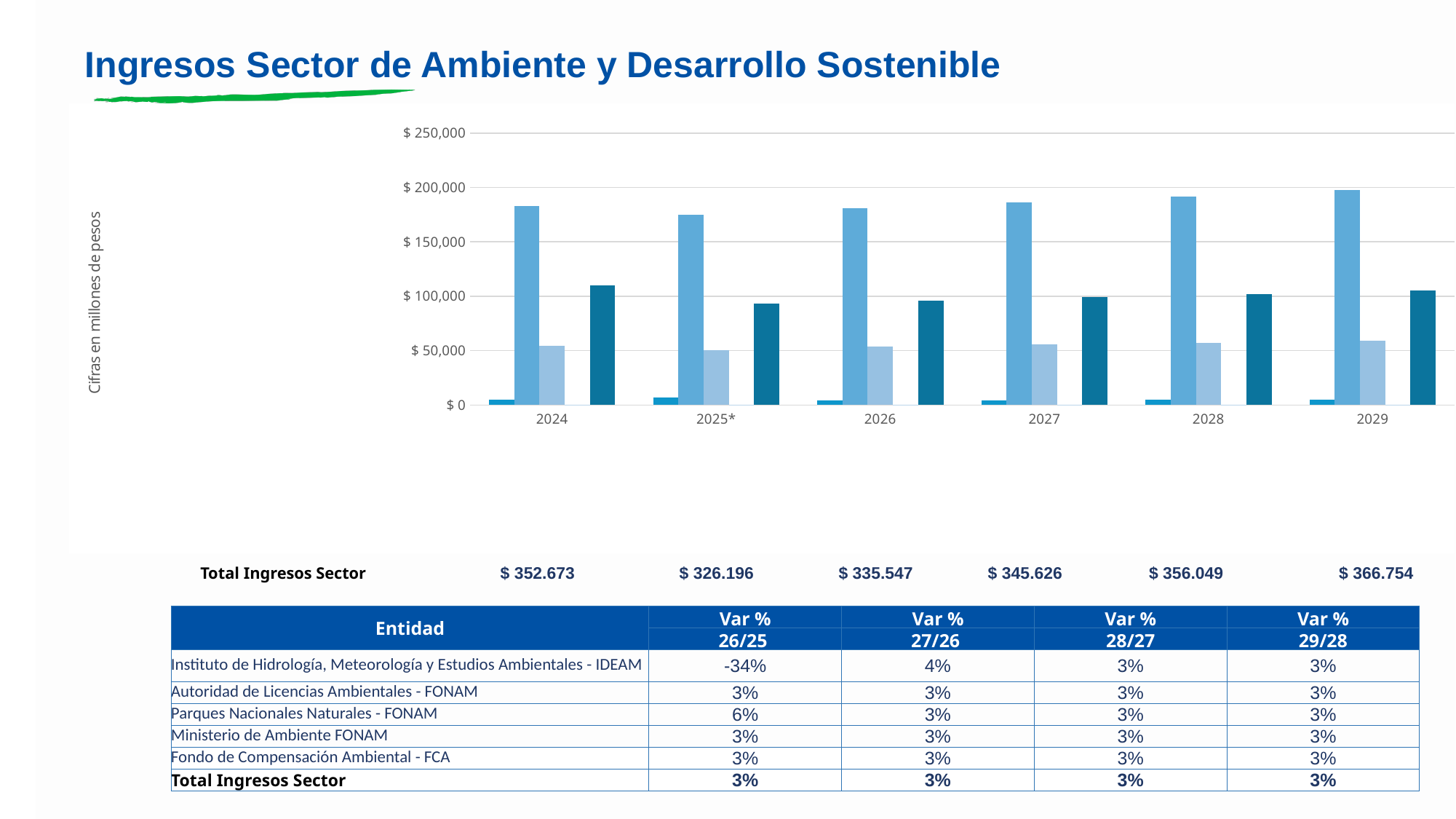
What is the label of the vertical axis of the chart? Cifras en millones de pesos Is the value of the dark teal bar for 2024 greater or less than 100,000? greater How many year categories are shown on the x axis of the chart? 6 Does the tallest (medium blue) bar rise or fall from 2025* to 2029? rise What kind of chart is shown on the slide? bar chart Is the dark teal bar for 2024 larger or smaller than the dark teal bar for 2025*? larger Which year on the x axis is marked with an asterisk? 2025* Is the value of the dark teal bar for 2025* greater or less than 100,000? less In which year is the tallest (medium blue) bar at its highest? 2029 What is the Total Ingresos Sector value shown for 2029? $ 366.754 Is the value of the tallest (medium blue) bar for 2024 greater or less than 150,000? greater